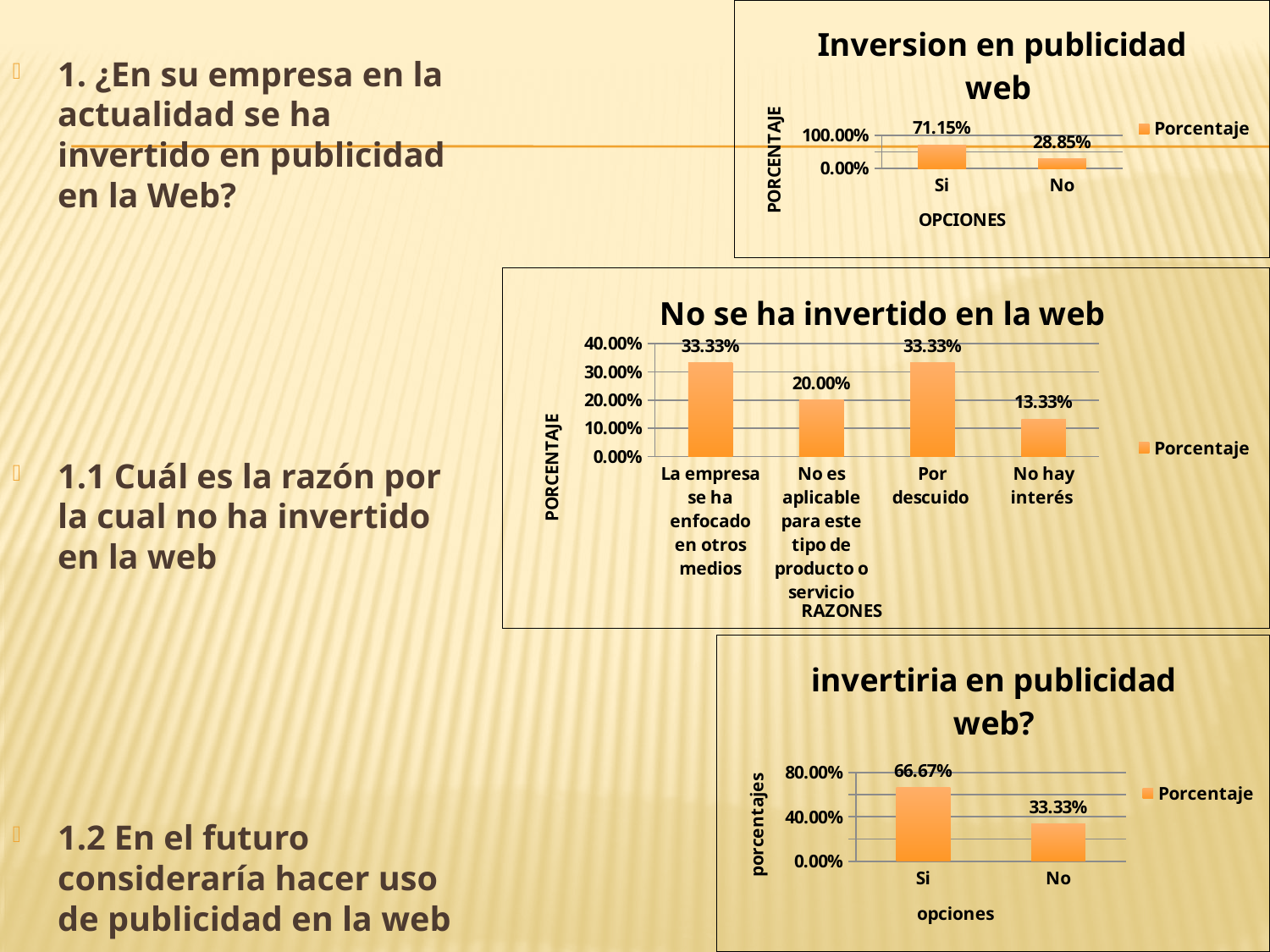
In the chart titled "invertiria en publicidad web?", what is the value for "Si"? 66.67% In the chart titled "invertiria en publicidad web?", which is larger, the value for "Si" or the value for "No"? Si In the chart titled "No se ha invertido en la web", what is the value for "No hay interés"? 13.33% In the chart titled "No se ha invertido en la web", is the value for "No es aplicable para este tipo de producto o servicio" greater or less than 30.00%? less In the chart titled "No se ha invertido en la web", which category has the lowest value? No hay interés In the chart titled "No se ha invertido en la web", how many categories are shown? 4 In the chart titled "Inversion en publicidad web", what is the difference between the values for "Si" and "No"? 42.30% In the chart titled "Inversion en publicidad web", what is the value for "No"? 28.85% In the chart titled "Inversion en publicidad web", what is the value for "Si"? 71.15% In the chart titled "invertiria en publicidad web?", what is the difference between the values for "Si" and "No"? 33.34% In the chart titled "No se ha invertido en la web", what is the value for "Por descuido"? 33.33% What kind of chart is the chart titled "No se ha invertido en la web"? bar chart